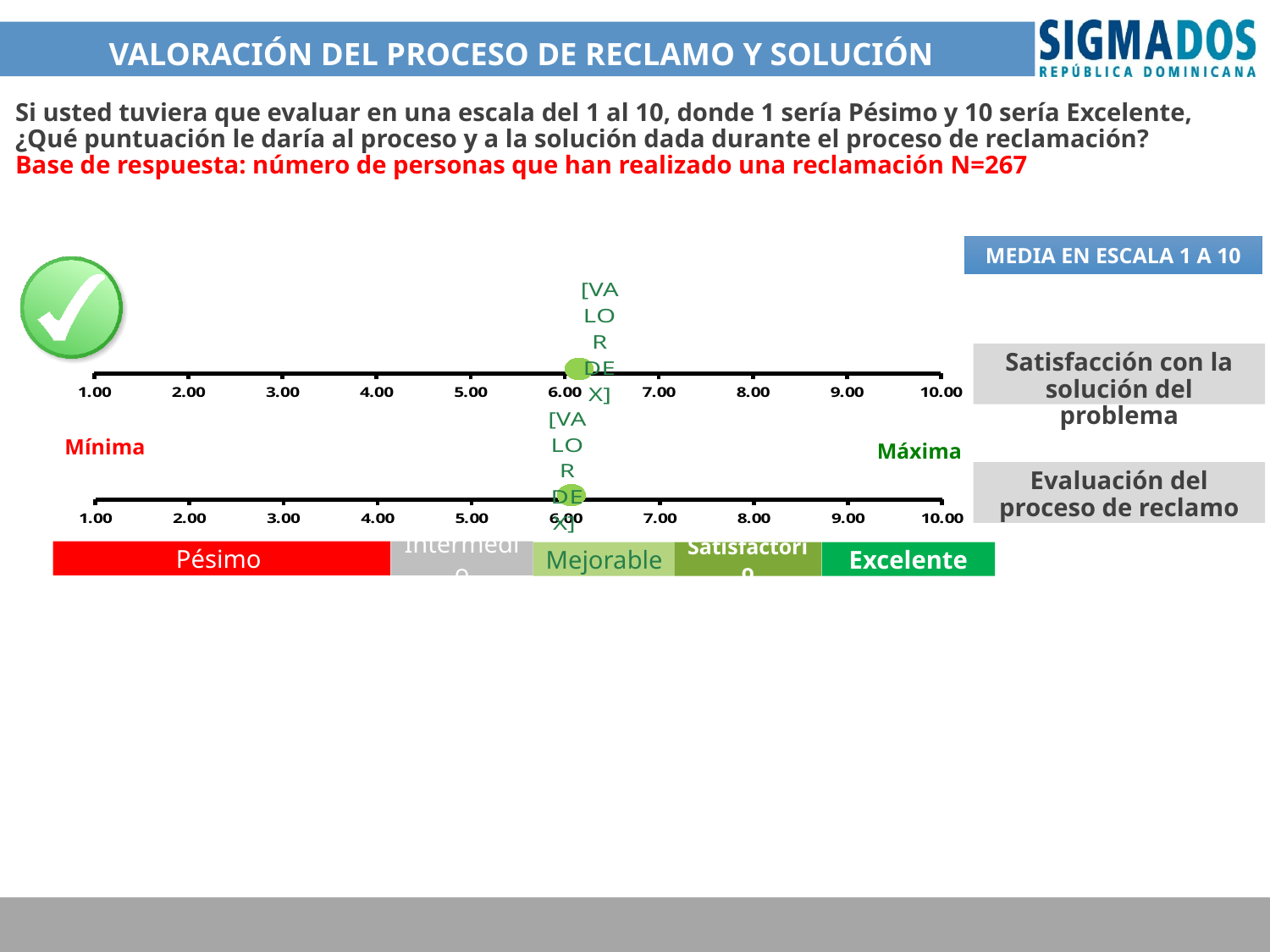
Which band in the colour legend below the charts is shown in red? Pésimo What is the lowest tick label on the axis of the bottom scale chart? 1.00 On the bottom scale chart, is the plotted value greater or less than 3.00? greater On the top scale chart (Satisfacción con la solución del problema), is the plotted value greater or less than 7.00? less On the top scale chart, is the plotted value greater or less than 9.00? less What is the highest tick label on the axis of the top scale chart? 10.00 What label appears at the left end of the scales, below the 1.00 tick? Mínima How many tick labels are shown along the axis of the top scale chart? 10